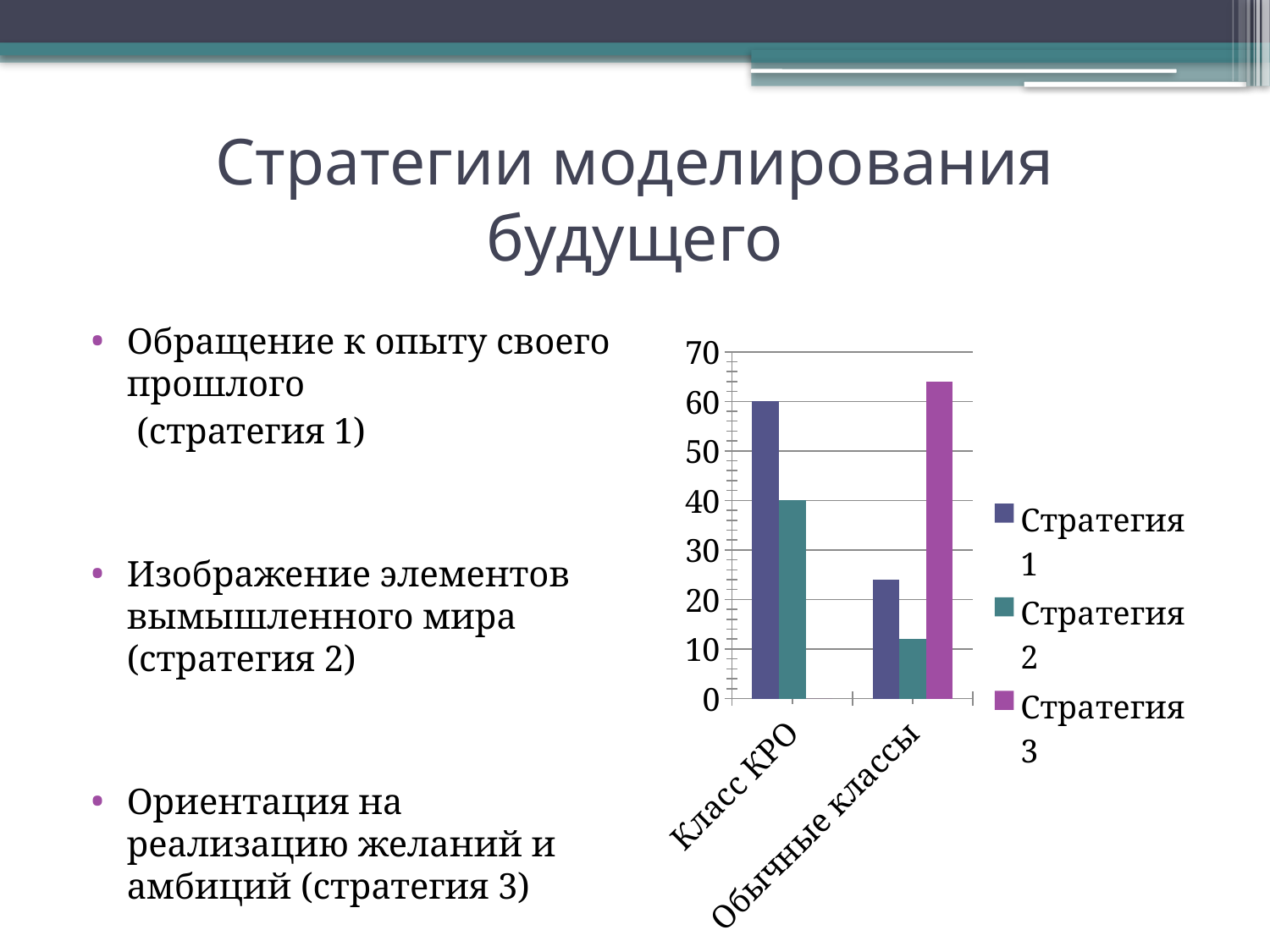
Is the value for Стратегия 3 in Обычные классы greater or less than 60? greater Is the value for Стратегия 1 in Класс КРО greater or less than 50? greater How many series does the chart legend list? 3 Which category has the larger value for Стратегия 1: Класс КРО or Обычные классы? Класс КРО Is the value for Стратегия 1 in Обычные классы greater or less than 30? less Which strategy has the lowest value for Обычные классы? Стратегия 2 What kind of chart is shown on the slide? Bar chart How many categories are shown on the x axis of the chart? 2 Which series is shown in purple in the chart legend? Стратегия 3 Which strategy has the highest value for Обычные классы? Стратегия 3 Which strategy has the highest value for Класс КРО? Стратегия 1